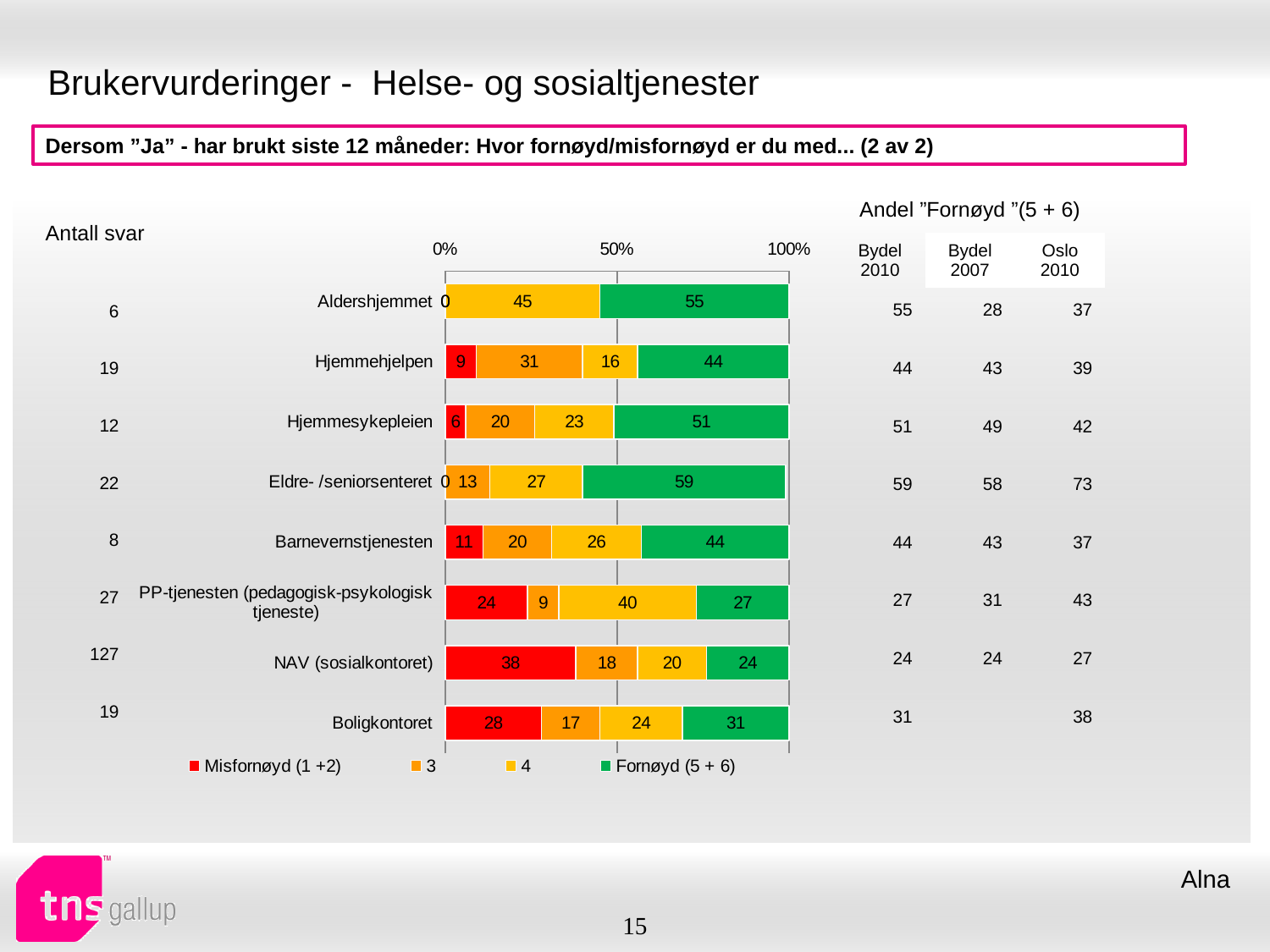
What is the value of the "Misfornøyd (1 +2)" segment for Boligkontoret? 28 Which category has the highest "Fornøyd (5 + 6)" value? Eldre- /seniorsenteret Which has the larger "Misfornøyd (1 +2)" value, NAV (sosialkontoret) or Boligkontoret? NAV (sosialkontoret) What kind of chart is shown on the slide? Stacked bar chart How many series does the legend list? 4 What is the value of the "4" segment for PP-tjenesten (pedagogisk-psykologisk tjeneste)? 40 Which colour represents "Fornøyd (5 + 6)" in the legend? Green What is the difference between the "Fornøyd (5 + 6)" values for Aldershjemmet and Boligkontoret? 24 What is the total of the stacked bar for Hjemmehjelpen? 100 How many categories are shown in the bar chart? 8 Which category has the lowest "Fornøyd (5 + 6)" value? NAV (sosialkontoret) What is the value of the "Fornøyd (5 + 6)" segment for NAV (sosialkontoret)? 24